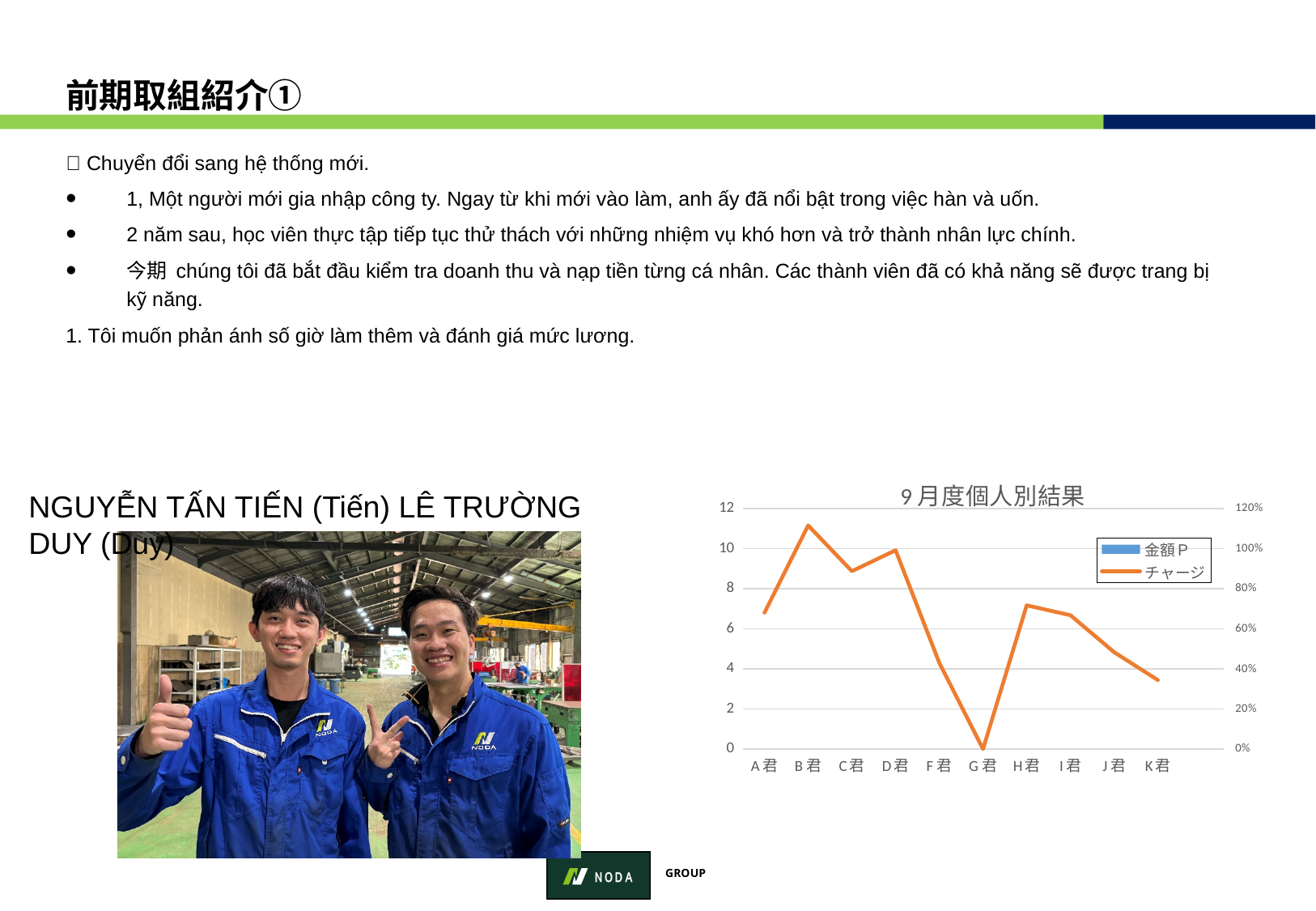
What is the title of the chart on the slide? 9月度個人別結果 What are the two entries in the chart legend? 金額P and チャージ Which category has the lowest チャージ value in the chart? G君 Which category has the highest チャージ value in the chart? B君 On the left-hand axis scale, is the チャージ value for K君 greater or less than 4? less Which has the larger チャージ value, D君 or F君? D君 How many series does the chart legend list? 2 How many categories are shown along the x axis of the chart? 10 On the left-hand axis scale, is the チャージ value for B君 greater or less than 10? greater Which has the larger チャージ value, B君 or C君? B君 What kind of chart is shown on the slide? line chart Does the チャージ line rise or fall from H君 to K君? fall